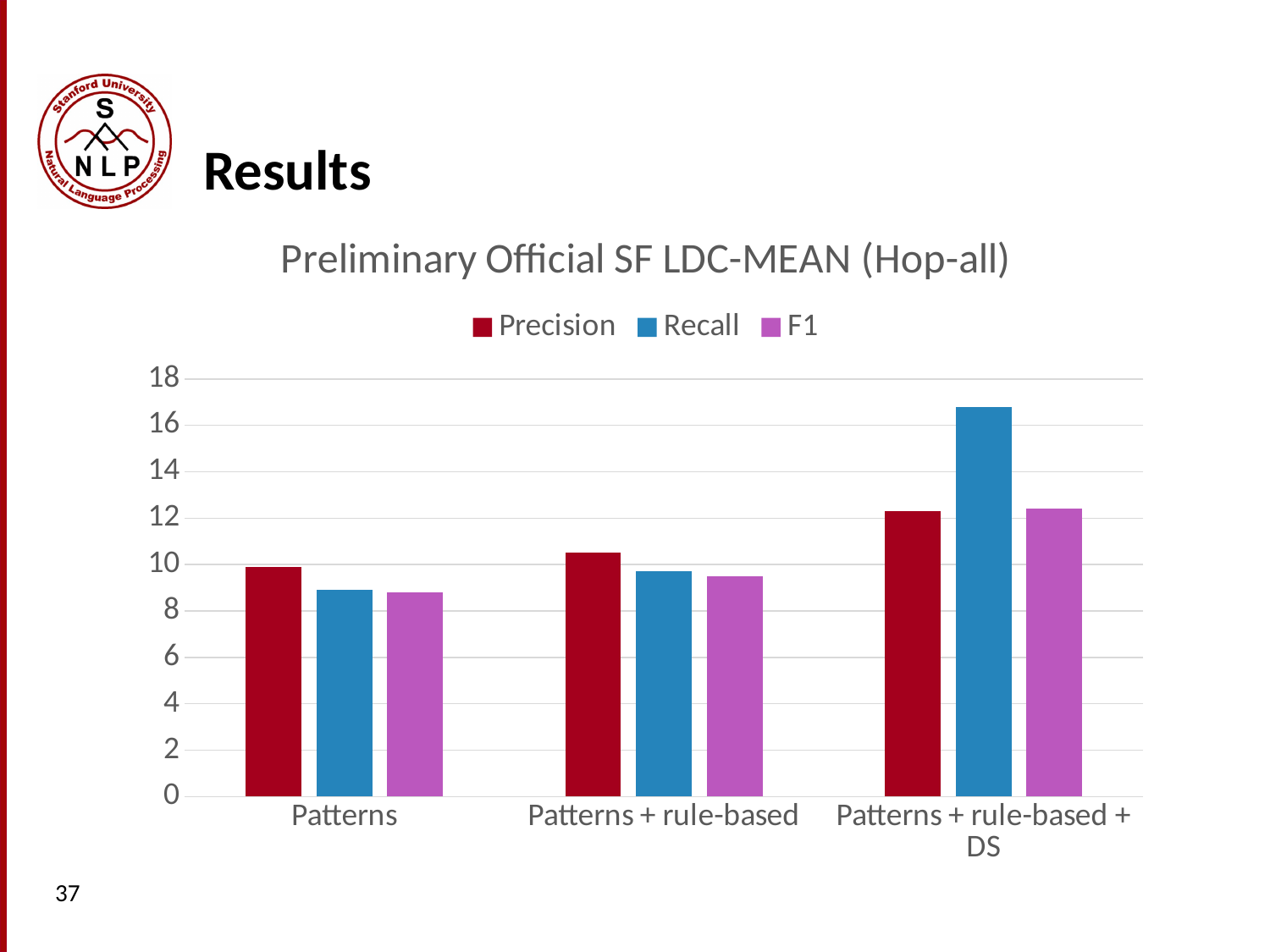
For Patterns, which is larger, Precision or Recall? Precision For Patterns + rule-based + DS, which is larger, Precision or Recall? Recall Which category has the highest Recall value? Patterns + rule-based + DS What is the title of the chart? Preliminary Official SF LDC-MEAN (Hop-all) How many categories are shown on the x axis? 3 What kind of chart is shown on the slide? bar chart Do the Precision values rise or fall from Patterns to Patterns + rule-based + DS? rise Is the Recall value for Patterns + rule-based + DS greater or less than 16? greater Which category has the lowest Precision value? Patterns Is the Recall value for Patterns greater or less than 10? less Is the Precision value for Patterns + rule-based greater or less than 10? greater How many series does the legend list? 3